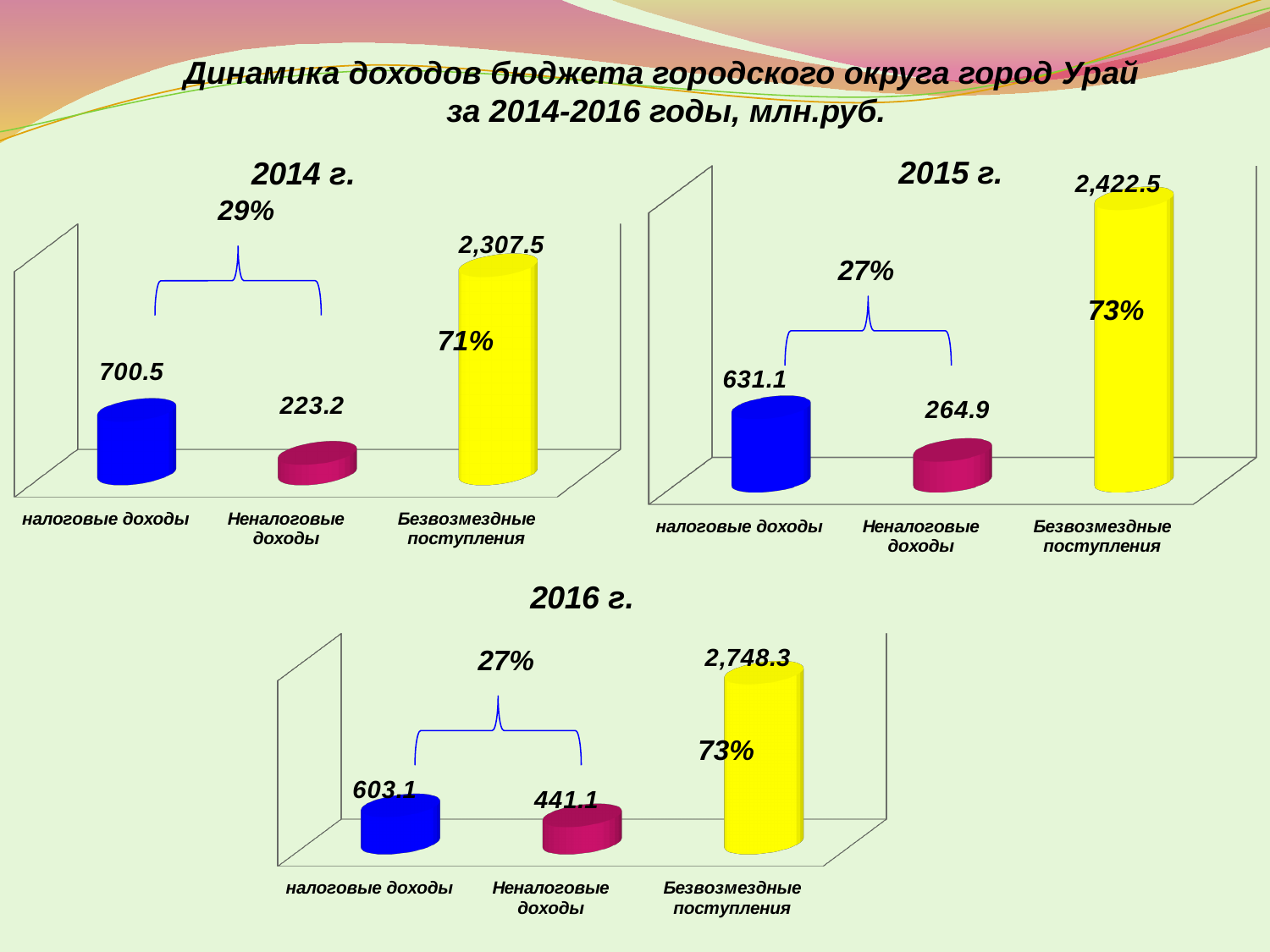
How many categories are shown in the 2016 г. chart? 3 In the 2014 г. chart, which category has the lowest value? Неналоговые доходы In the 2016 г. chart, what is the value for Безвозмездные поступления? 2,748.3 In the 2015 г. chart, which category has the highest value? Безвозмездные поступления In the 2015 г. chart, what is the difference between налоговые доходы and Неналоговые доходы? 366.2 In the 2014 г. chart, what is the value for налоговые доходы? 700.5 In the 2015 г. chart, what is the value for Неналоговые доходы? 264.9 In the 2016 г. chart, what percentage is printed on the Безвозмездные поступления bar? 73% In the 2014 г. chart, what percentage is shown above the bracket over налоговые доходы and Неналоговые доходы? 29% What kind of chart is the 2014 г. chart? bar chart In the 2016 г. chart, which is larger: налоговые доходы or Неналоговые доходы? налоговые доходы In the 2014 г. chart, what is the difference between налоговые доходы and Неналоговые доходы? 477.3